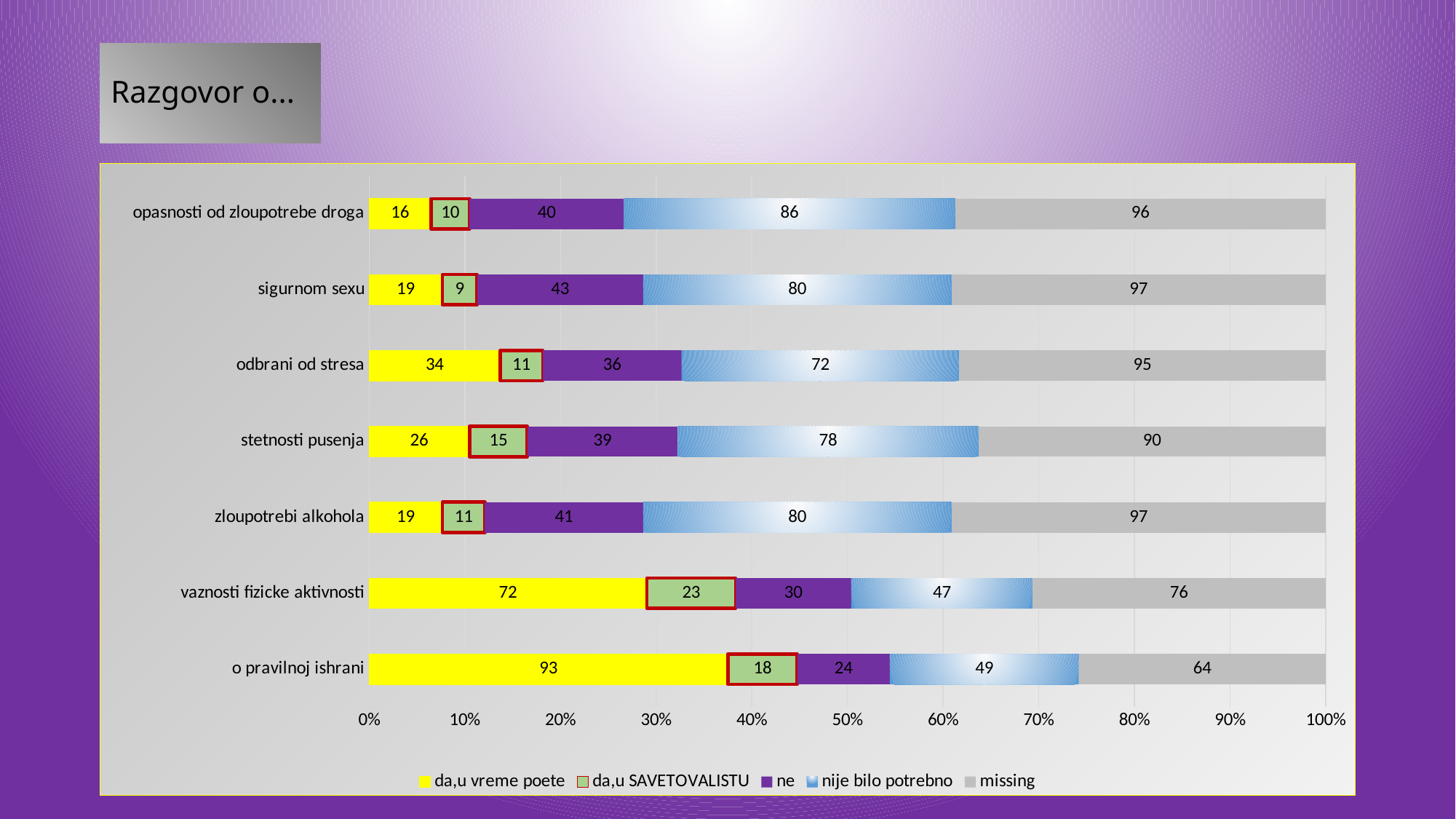
What is the difference between the "ne" values for "sigurnom sexu" and "o pravilnoj ishrani"? 19 Which category has the lowest value for "da,u vreme poete"? opasnosti od zloupotrebe droga How many categories are shown on the chart? 7 How many series does the legend list? 5 What kind of chart is shown on the slide? stacked bar chart Which is larger: the "missing" value for "zloupotrebi alkohola" or for "vaznosti fizicke aktivnosti"? zloupotrebi alkohola What is the total of all segments in the bar for "odbrani od stresa"? 248 What is the value of "missing" for "stetnosti pusenja"? 90 Which category has the highest value for "da,u SAVETOVALISTU"? vaznosti fizicke aktivnosti What is the value of "da,u vreme poete" for "o pravilnoj ishrani"? 93 Which series is shown in yellow? da,u vreme poete What is the value of "nije bilo potrebno" for "opasnosti od zloupotrebe droga"? 86